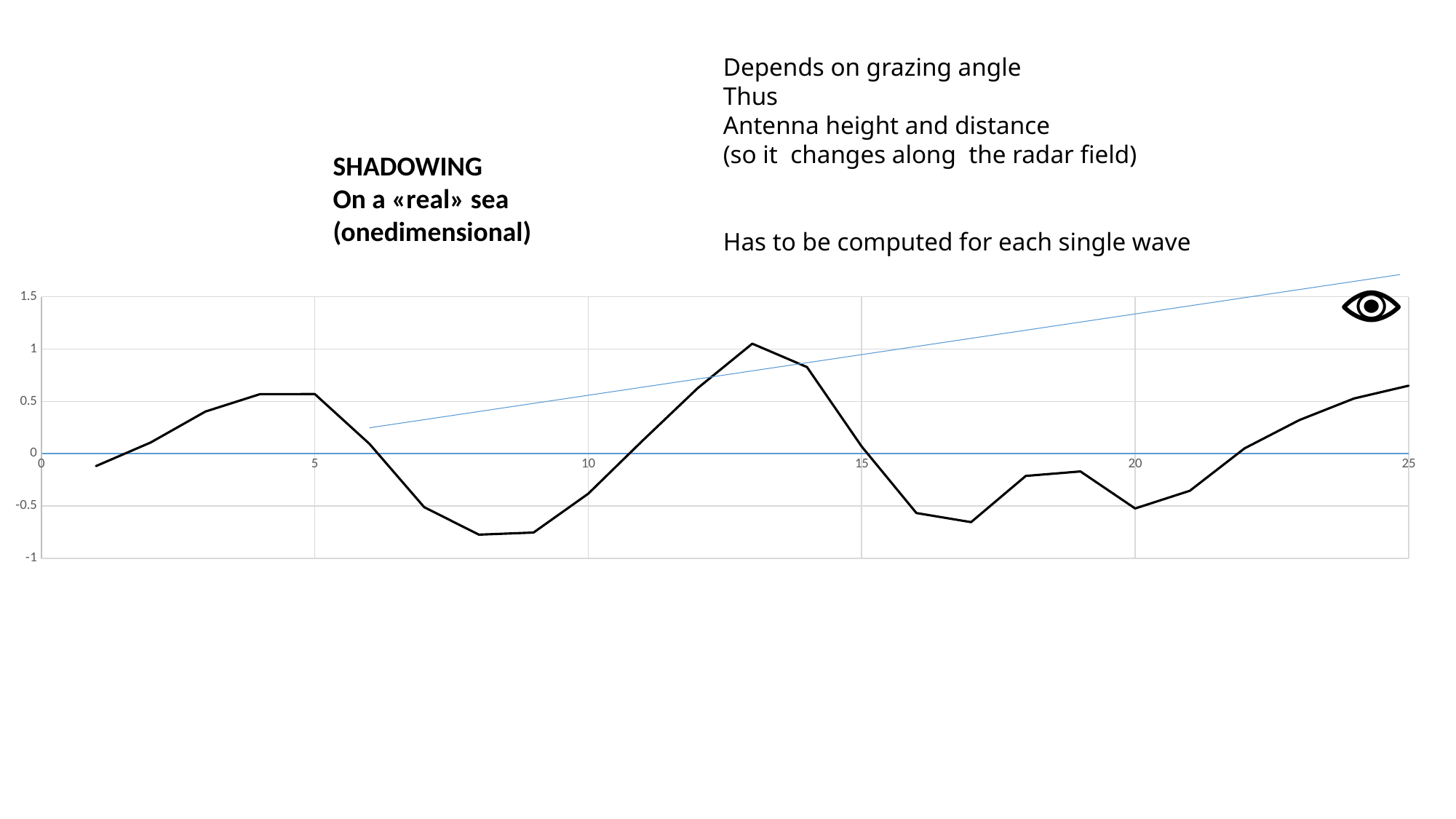
Is the value of the black line at x = 10 greater or less than 0? less What kind of chart is shown on the slide? line chart How many lines are plotted on the chart? 1 Which is larger, the value of the black line at x = 5 or at x = 10? x = 5 Between which two labelled x-axis ticks does the black line reach its highest value? 10 and 15 What is the highest value labelled on the y axis? 1.5 Which is larger, the value of the black line at x = 15 or at x = 20? x = 15 What is the largest value labelled on the x axis? 25 Is the lowest point of the black line between x = 5 and x = 10 greater or less than -0.5? less Does the black line rise or fall between x = 20 and x = 25? rise Is the value of the black line at x = 25 greater or less than 0.5? greater